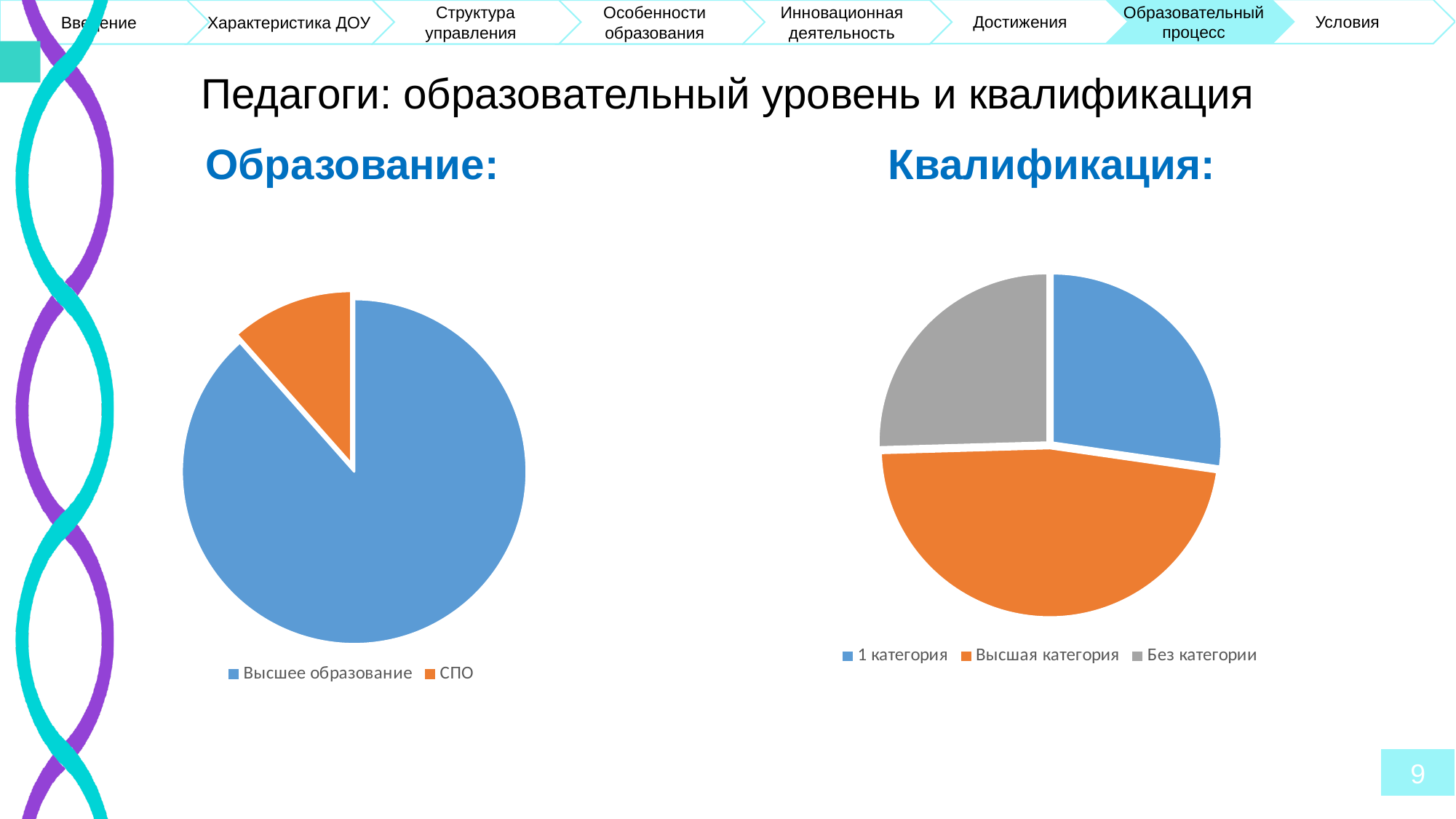
In the 'Образование' chart, which category has the smallest slice? СПО In the 'Образование' chart, which is larger: 'СПО' or 'Высшее образование'? Высшее образование How many entries does the legend of the 'Квалификация' chart list? 3 In the 'Образование' chart, which category has the largest slice? Высшее образование In the 'Образование' chart, how many slices does the pie have? 2 What kind of chart is the 'Квалификация' chart on the right? pie chart What kind of chart is the 'Образование' chart on the left? pie chart In the 'Квалификация' chart, what colour is the 'Без категории' slice? grey In the 'Квалификация' chart, which category has the largest slice? Высшая категория In the 'Квалификация' chart, how many slices does the pie have? 3 In the 'Квалификация' chart, which is larger: 'Высшая категория' or '1 категория'? Высшая категория How many entries does the legend of the 'Образование' chart list? 2